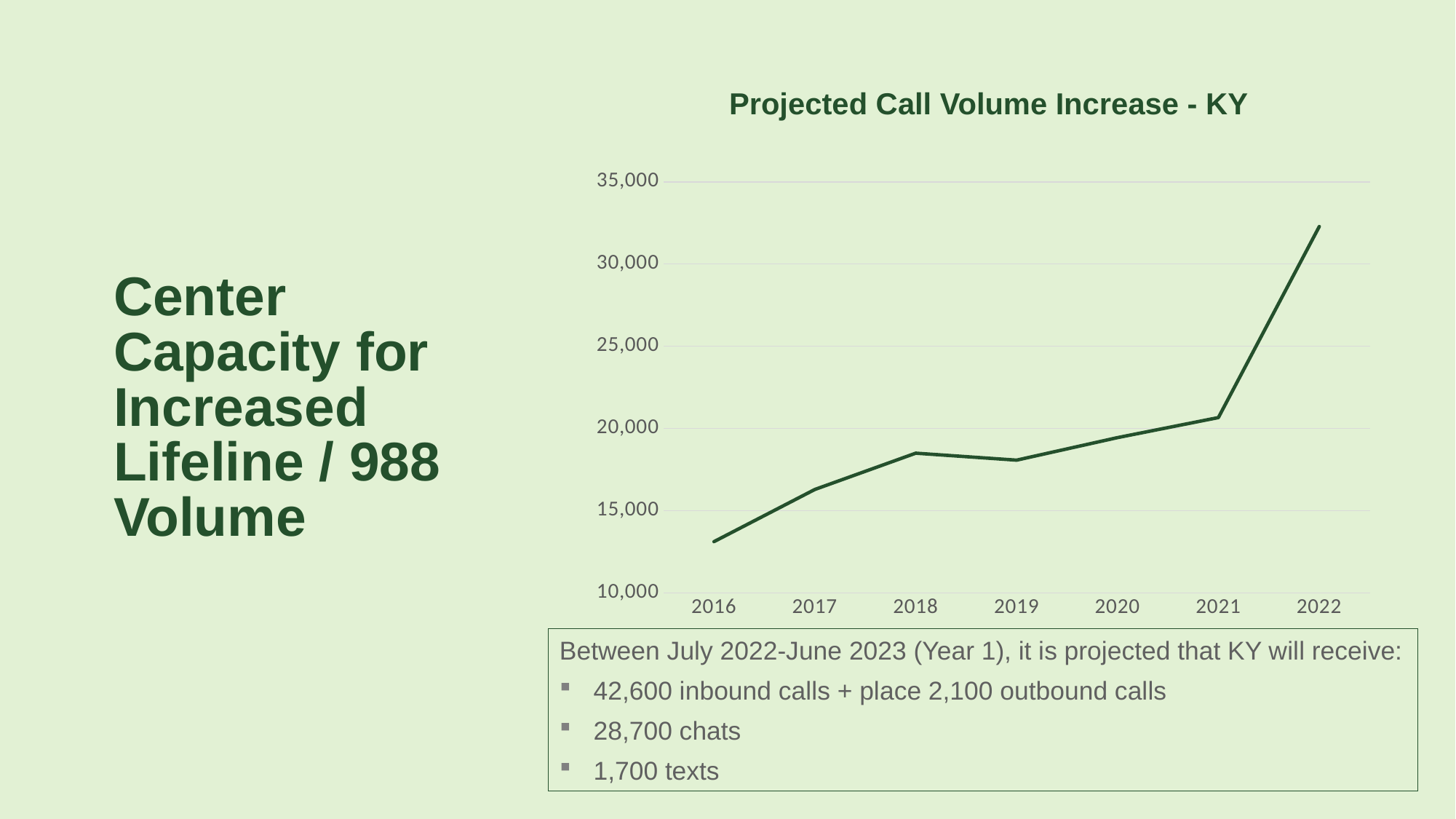
Is the value for 2022 greater or less than 30,000? greater Which year has the highest projected call volume? 2022 What is the highest value shown on the y axis of the chart? 35,000 Does the projected call volume generally rise or fall from 2016 to 2022? rise What kind of chart is shown on the slide? line chart Which year has a larger projected call volume, 2017 or 2021? 2021 What is the title of the chart? Projected Call Volume Increase - KY Which year has the lowest projected call volume? 2016 Is the value for 2016 greater or less than 15,000? less Is the value for 2021 greater or less than 20,000? greater How many years are plotted on the x axis of the chart? 7